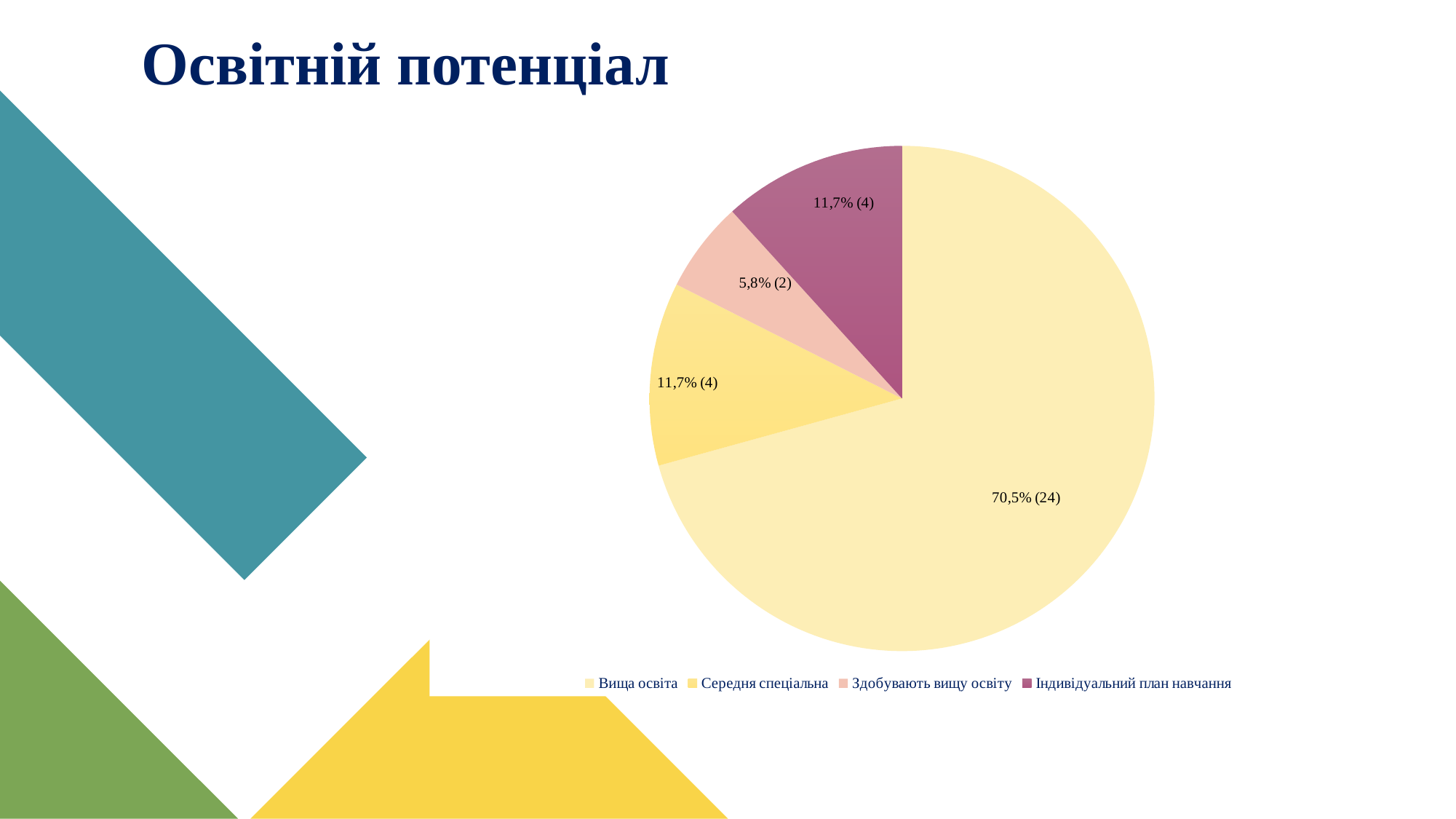
Which category has the largest slice of the pie? Вища освіта What share of the pie does the "Здобувають вищу освіту" slice represent? 5,8% How many people are in the "Здобувають вищу освіту" category according to the data label? 2 What kind of chart is shown on the slide? pie chart Which category has the smallest slice of the pie? Здобувають вищу освіту What share of the pie does the "Середня спеціальна" slice represent? 11,7% Which is larger: the "Вища освіта" slice or the "Середня спеціальна" slice? Вища освіта What is the difference in count between "Вища освіта" (24) and "Середня спеціальна" (4)? 20 How many people are in the "Індивідуальний план навчання" category according to the data label? 4 What share of the pie does the "Вища освіта" slice represent? 70,5% How many categories does the legend of the pie chart list? 4 How many people are in the "Вища освіта" category according to the data label? 24